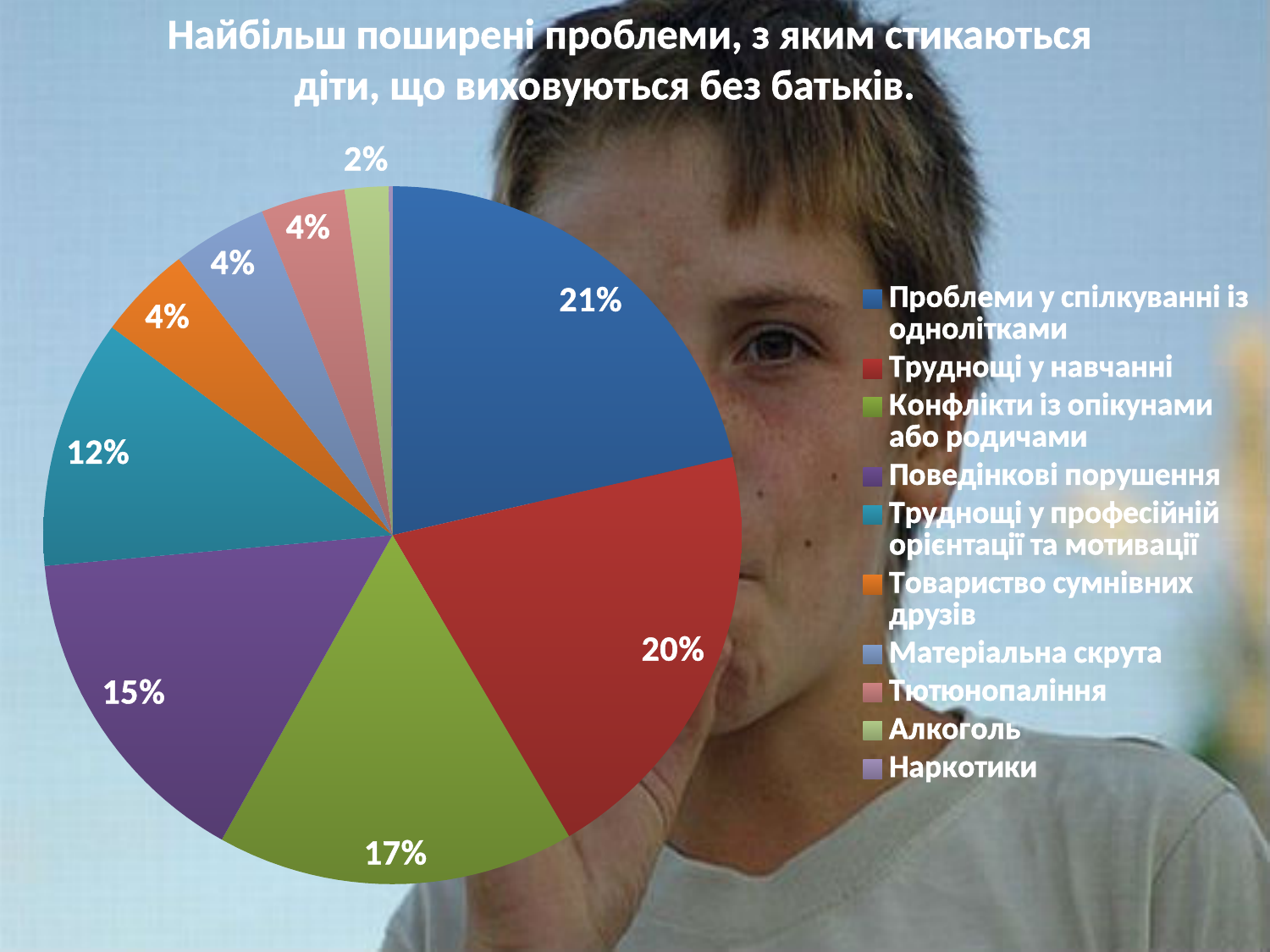
What colour is the slice for "Труднощі у навчанні"? red What is the difference in percentage points between "Труднощі у навчанні" and "Поведінкові порушення"? 5 Which is larger: the slice for "Конфлікти із опікунами або родичами" or the slice for "Труднощі у професійній орієнтації та мотивації"? Конфлікти із опікунами або родичами Which category has the largest slice of the pie? Проблеми у спілкуванні із однолітками How many categories does the legend list? 10 What share of the pie is labelled for "Проблеми у спілкуванні із однолітками"? 21% What percentage is shown for "Труднощі у професійній орієнтації та мотивації"? 12% What percentage is shown for "Поведінкові порушення"? 15% What percentage is shown for "Труднощі у навчанні"? 20% What percentage is shown for "Алкоголь"? 2% What percentage is shown for "Конфлікти із опікунами або родичами"? 17% What type of chart is shown on the slide? pie chart